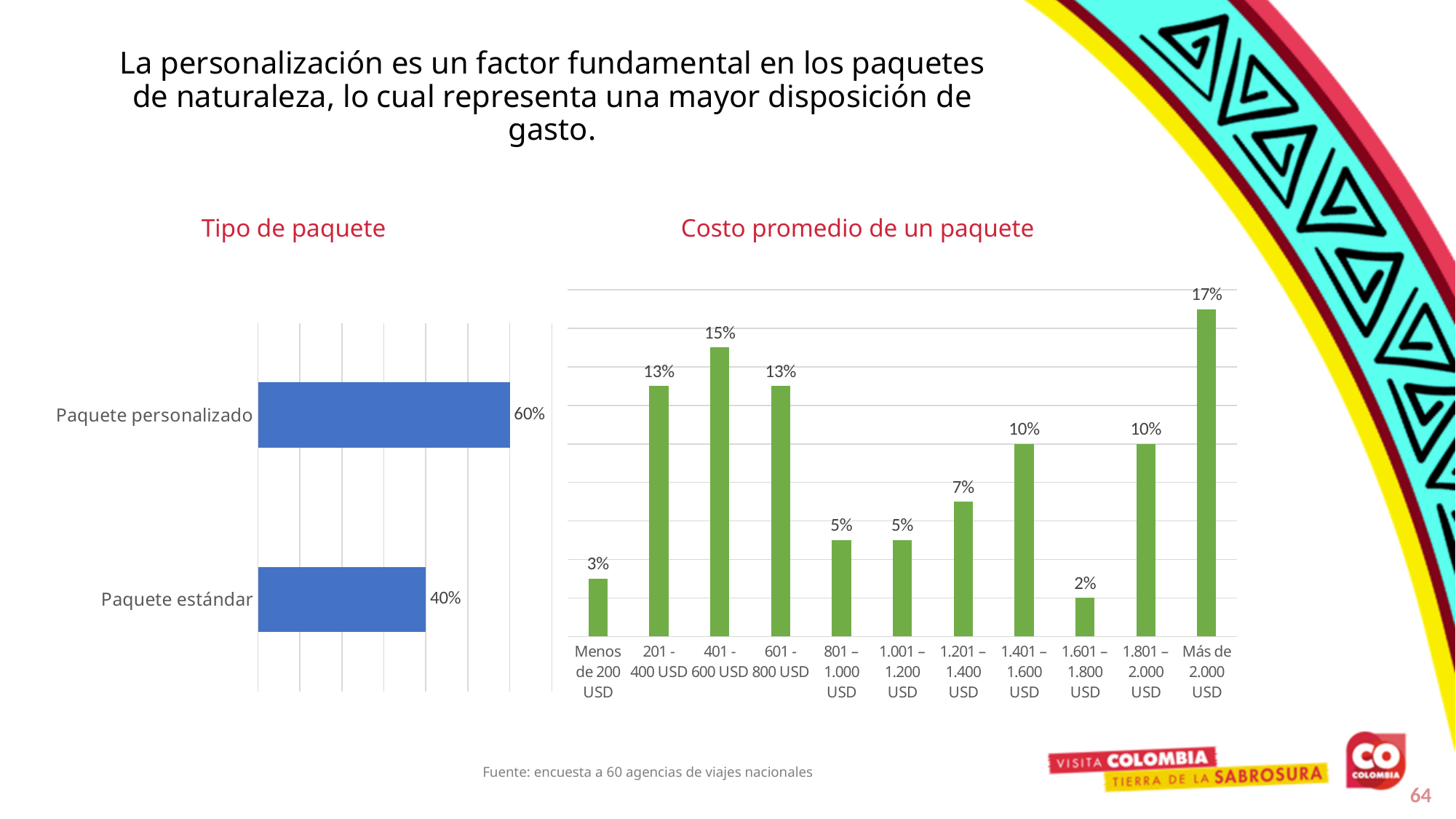
What colour are the bars in the 'Costo promedio de un paquete' chart? Green In the 'Tipo de paquete' chart, what is the value for Paquete estándar? 40% In the 'Tipo de paquete' chart, what is the difference between Paquete personalizado and Paquete estándar? 20% In the 'Costo promedio de un paquete' chart, which category has the lowest value? 1.601 – 1.800 USD In the 'Costo promedio de un paquete' chart, what is the value for '401 - 600 USD'? 15% In the 'Costo promedio de un paquete' chart, which category has the highest value? Más de 2.000 USD In the 'Tipo de paquete' chart, what is the value for Paquete personalizado? 60% In the 'Costo promedio de un paquete' chart, how many categories are shown? 11 In the 'Costo promedio de un paquete' chart, which is larger: '1.201 – 1.400 USD' or '801 – 1.000 USD'? 1.201 – 1.400 USD In the 'Costo promedio de un paquete' chart, what is the difference between 'Más de 2.000 USD' and 'Menos de 200 USD'? 14% What kind of chart is the 'Tipo de paquete' chart? Bar chart In the 'Costo promedio de un paquete' chart, what is the value for 'Más de 2.000 USD'? 17%